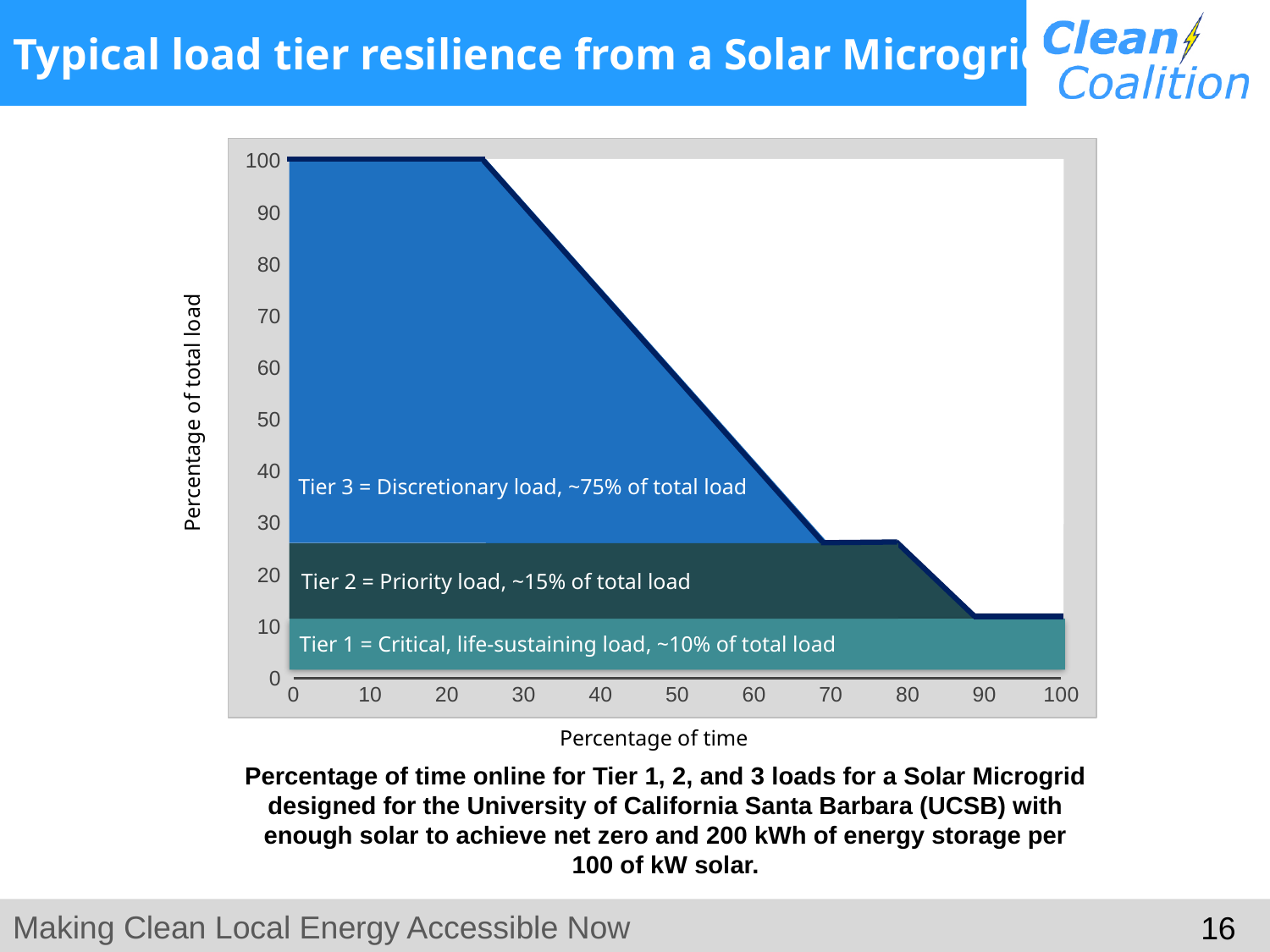
Is the percentage of total load at 40 percent of time greater or less than 70? greater Does the percentage of total load rise or fall as the percentage of time increases? fall Is the percentage of total load at 75 percent of time greater or less than 30? less What is the title of the y axis? Percentage of total load What is the percentage of total load at 10 percent of time? 100 What is the title of the x axis? Percentage of time What kind of chart is shown on the slide? area chart Which is larger, the percentage of total load at 20 percent of time or at 60 percent of time? 20 percent of time Is the percentage of total load at 100 percent of time greater or less than 20? less What is the percentage of total load at 0 percent of time? 100